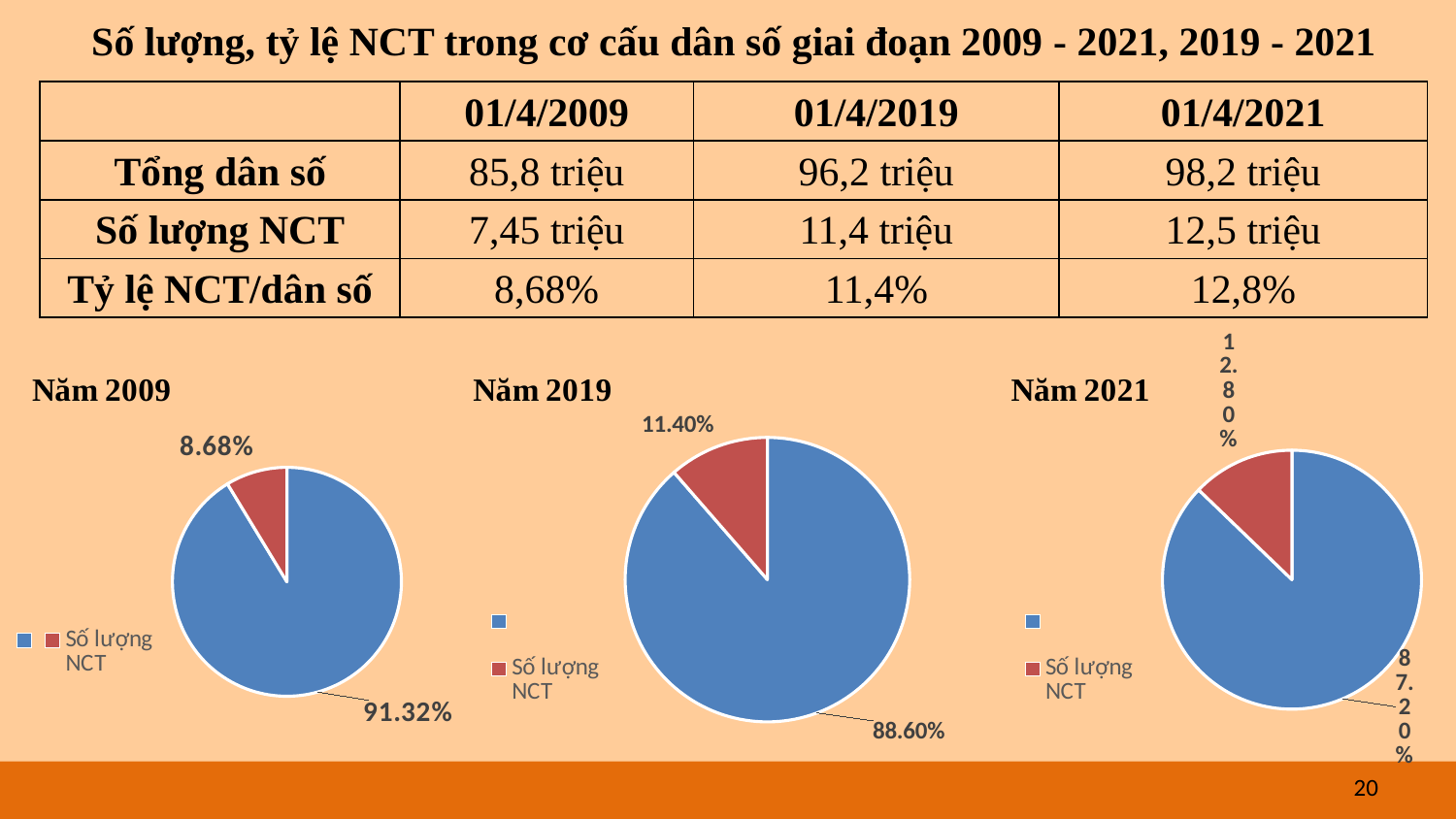
In the "Năm 2009" pie chart, what is the value of the larger (blue) slice? 91.32% How many slices does the "Năm 2019" pie chart have? 2 Across the three pie charts from 2009 to 2021, does the "Số lượng NCT" share rise or fall? rise In the "Năm 2021" pie chart, what share does the "Số lượng NCT" slice have? 12.80% In the "Năm 2019" pie chart, what share does the "Số lượng NCT" slice have? 11.40% Which is larger: the "Số lượng NCT" slice in the "Năm 2009" chart or in the "Năm 2021" chart? Năm 2021 In the "Năm 2019" pie chart, what is the value of the larger (blue) slice? 88.60% In the "Năm 2021" pie chart, what is the value of the larger (blue) slice? 87.20% In the "Năm 2009" pie chart, what share does the "Số lượng NCT" slice have? 8.68% What is the difference between the "Số lượng NCT" share in the "Năm 2021" chart and in the "Năm 2009" chart? 4.12% What kind of chart is the "Năm 2009" chart? pie chart What colour is the "Số lượng NCT" slice in the pie charts? red